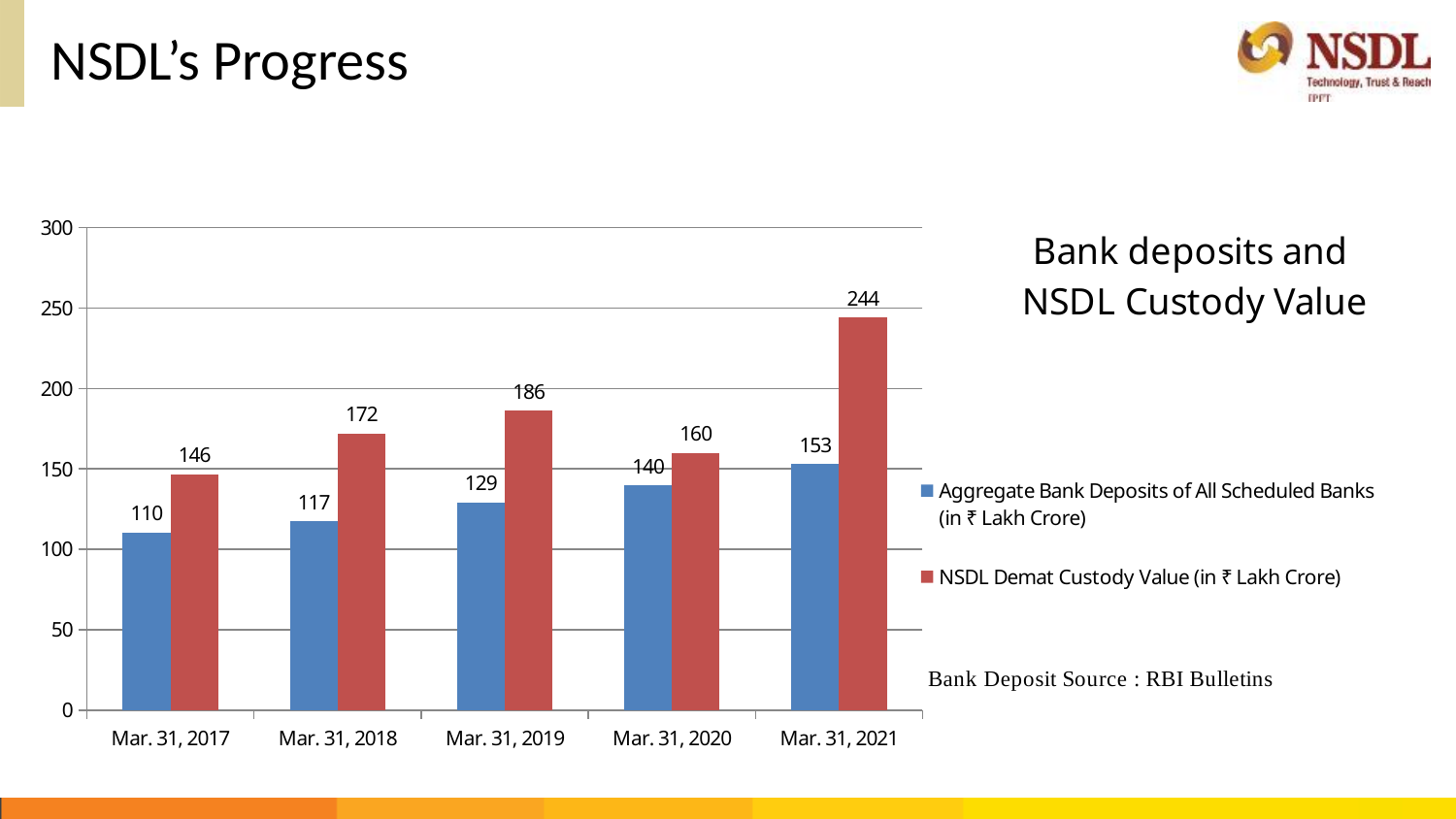
In which year is the Aggregate Bank Deposits value lowest? Mar. 31, 2017 In which year is the NSDL Demat Custody Value highest? Mar. 31, 2021 What kind of chart is shown on the slide? Bar chart What is the Aggregate Bank Deposits of All Scheduled Banks value on Mar. 31, 2017? 110 Which is larger on Mar. 31, 2020: Aggregate Bank Deposits or NSDL Demat Custody Value? NSDL Demat Custody Value Is the NSDL Demat Custody Value on Mar. 31, 2018 greater or less than 150? greater How many series does the legend list? 2 What is the difference between the NSDL Demat Custody Value and the Aggregate Bank Deposits on Mar. 31, 2021? 91 Does the Aggregate Bank Deposits value rise or fall from Mar. 31, 2017 to Mar. 31, 2021? Rise What is the NSDL Demat Custody Value on Mar. 31, 2019? 186 What is the NSDL Demat Custody Value on Mar. 31, 2021? 244 How many dates are shown on the x axis? 5